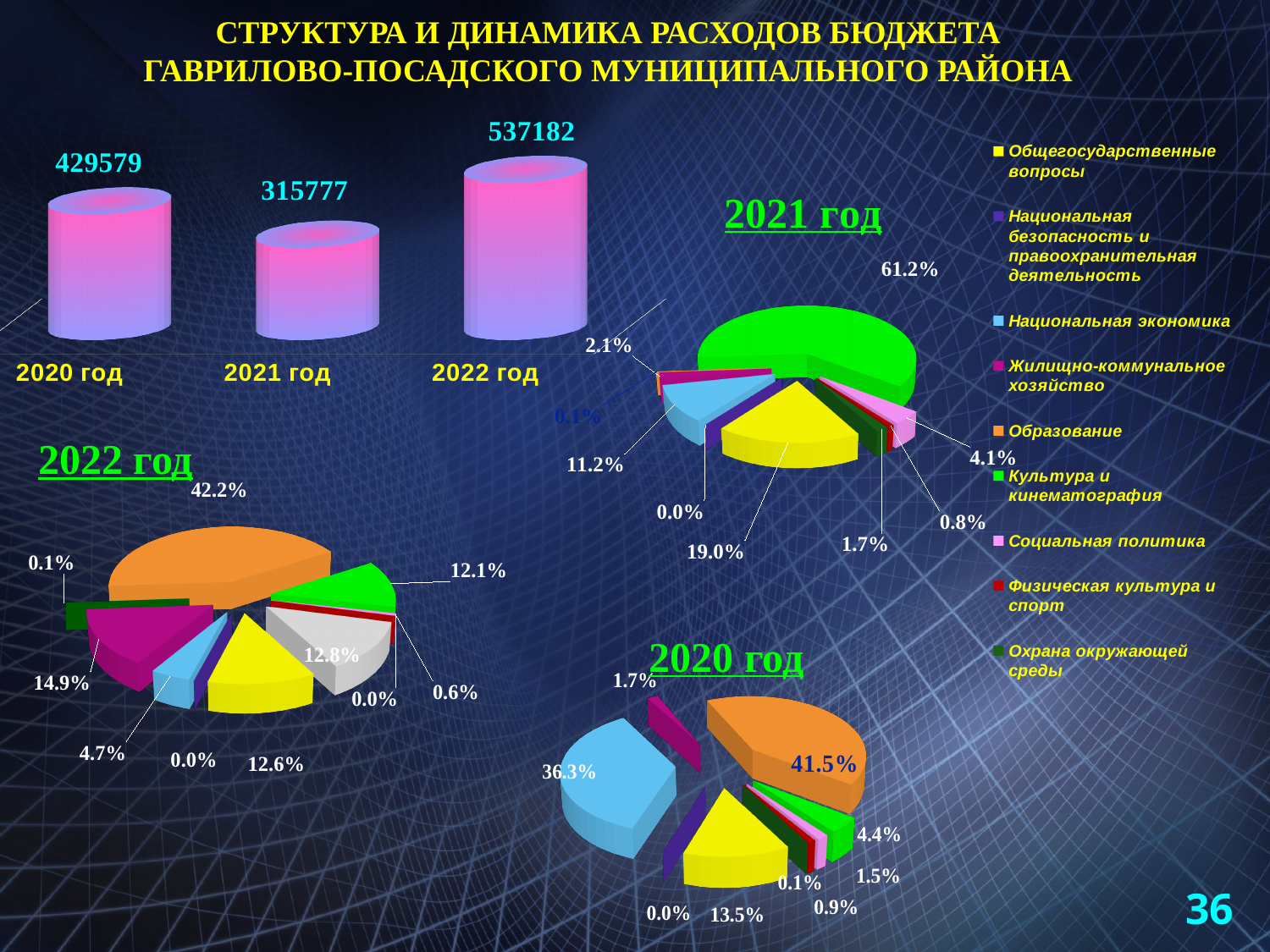
What kind of chart is the chart at the top left of the slide? bar chart How many bars are in the bar chart at the top left? 3 In the bar chart at the top left, which year has the highest value? 2022 год In the bar chart at the top left, which year has the lowest value? 2021 год In the bar chart at the top left, what is the value for 2021 год? 315777 In the bar chart at the top left, which is larger: the value for 2020 год or for 2021 год? 2020 год In the pie chart titled 2022 год, what is the share of the largest slice? 42.2% In the bar chart at the top left, what is the difference between the values for 2022 год and 2020 год? 107603 In the pie chart titled 2020 год, what is the share of the largest slice? 41.5% In the pie chart titled 2021 год, what is the share of the largest slice? 61.2% How many entries does the legend on the right side of the slide list? 9 In the bar chart at the top left, what is the value for 2022 год? 537182